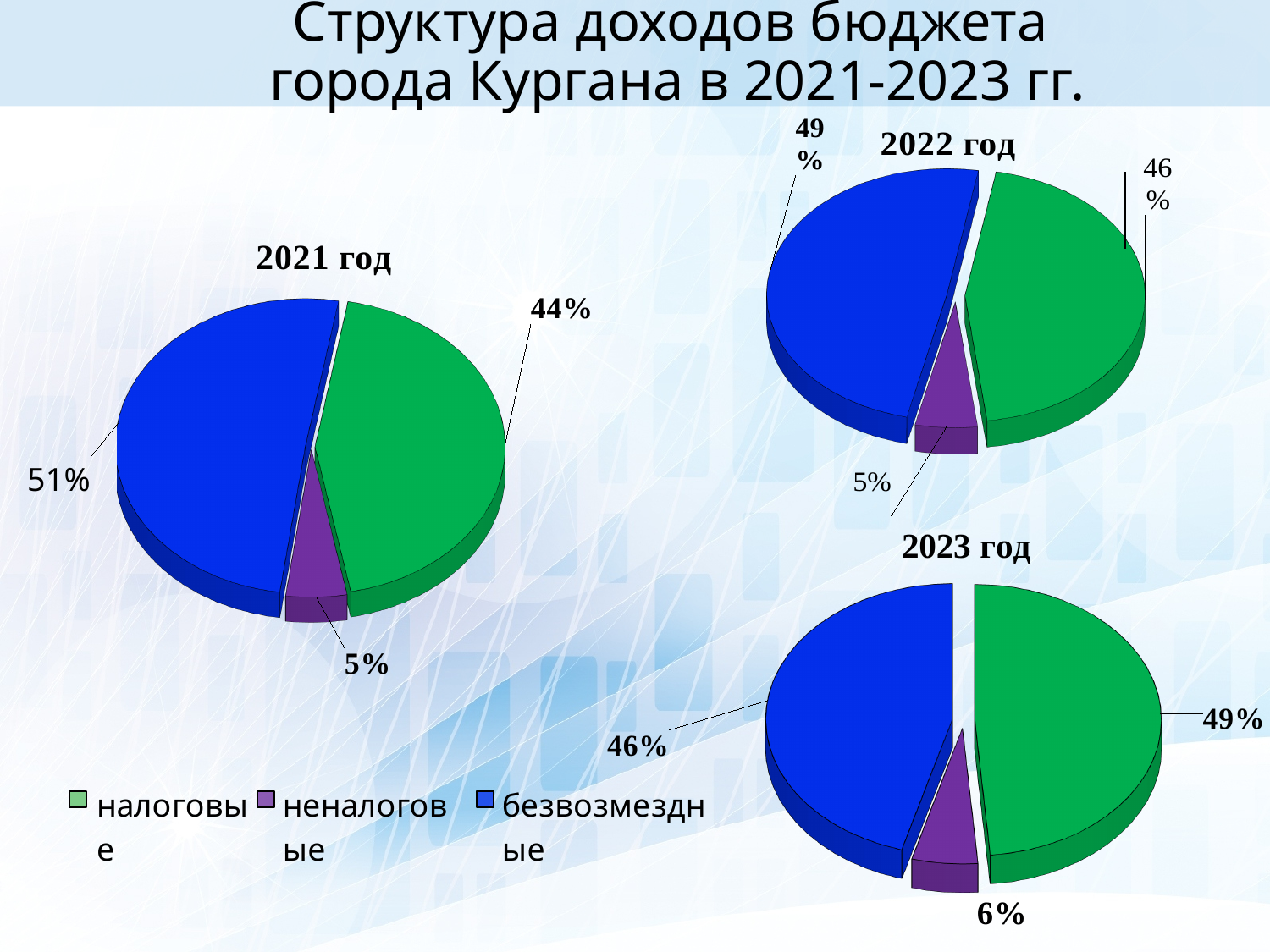
On the 2022 год chart, what is the difference between the безвозмездные share and the налоговые share? 3% How many categories does the legend list? 3 On the 2021 год chart, what share do налоговые revenues have? 44% On the 2023 год chart, what share do налоговые revenues have? 49% On the 2022 год chart, what share do неналоговые revenues have? 5% On the 2021 год chart, which category has the largest share? безвозмездные On the 2023 год chart, what share do безвозмездные revenues have? 46% On the 2021 год chart, what share do безвозмездные revenues have? 51% On the 2023 год chart, which is larger: the налоговые share or the безвозмездные share? налоговые How many charts are shown on the slide? 3 What type of chart is the 2022 год chart? pie chart On the 2023 год chart, which category has the smallest share? неналоговые